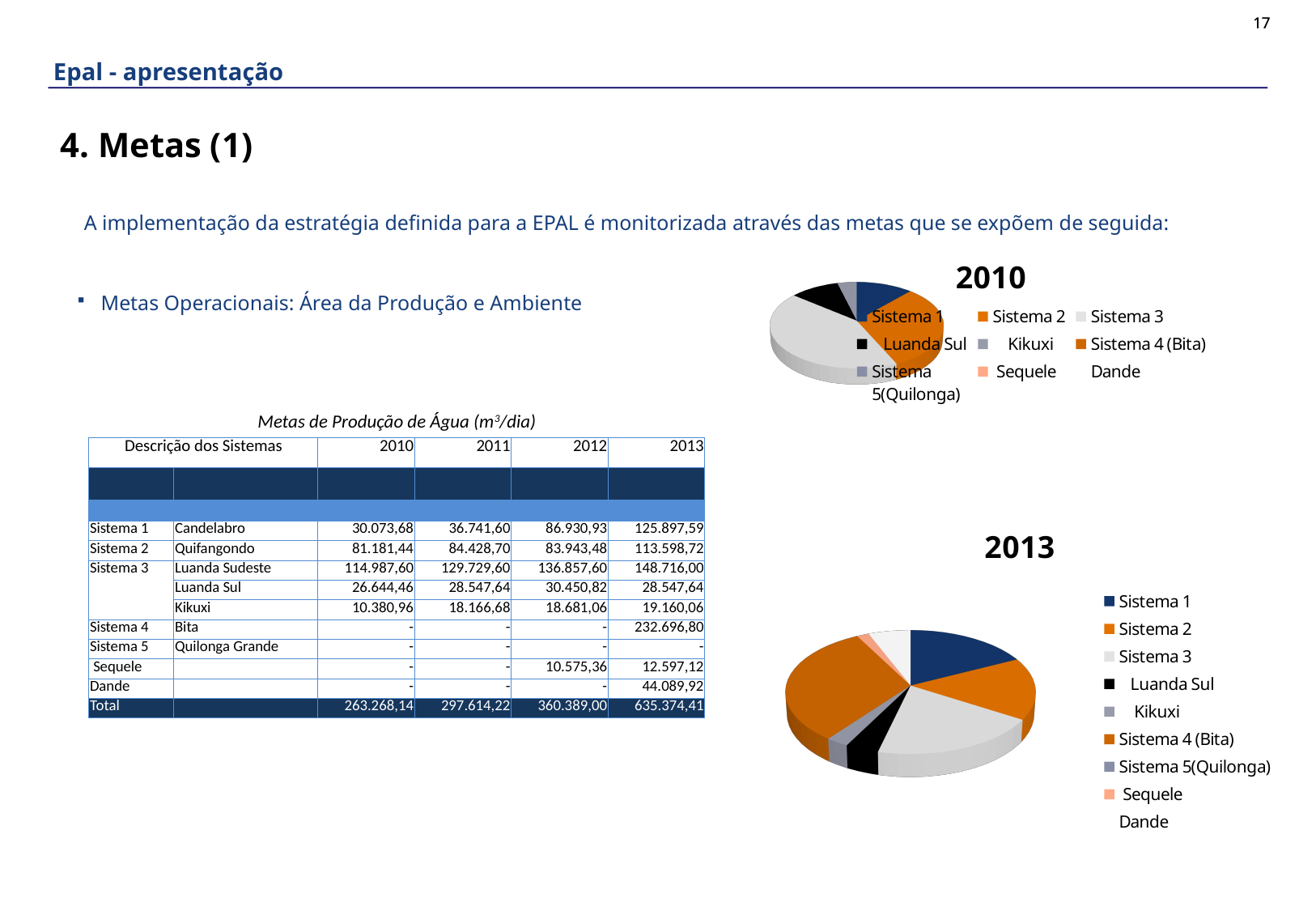
In the chart titled 2010, which category has the largest slice? Sistema 3 What kind of chart is the chart titled 2010? pie chart In the chart titled 2013, which category has the largest slice? Sistema 4 (Bita) In the chart titled 2013, which slice is larger, Sistema 4 (Bita) or Sistema 1? Sistema 4 (Bita) In the chart titled 2013, which slice is larger, Sistema 3 or Luanda Sul? Sistema 3 How many pie charts are shown on the slide? 2 What is the title of the upper pie chart on the slide? 2010 In the chart titled 2013, which slice is larger, Sistema 2 or Sequele? Sistema 2 What kind of chart is the chart titled 2013? pie chart In the chart titled 2013, how many entries does the legend list? 9 In the chart titled 2010, how many entries does the legend list? 9